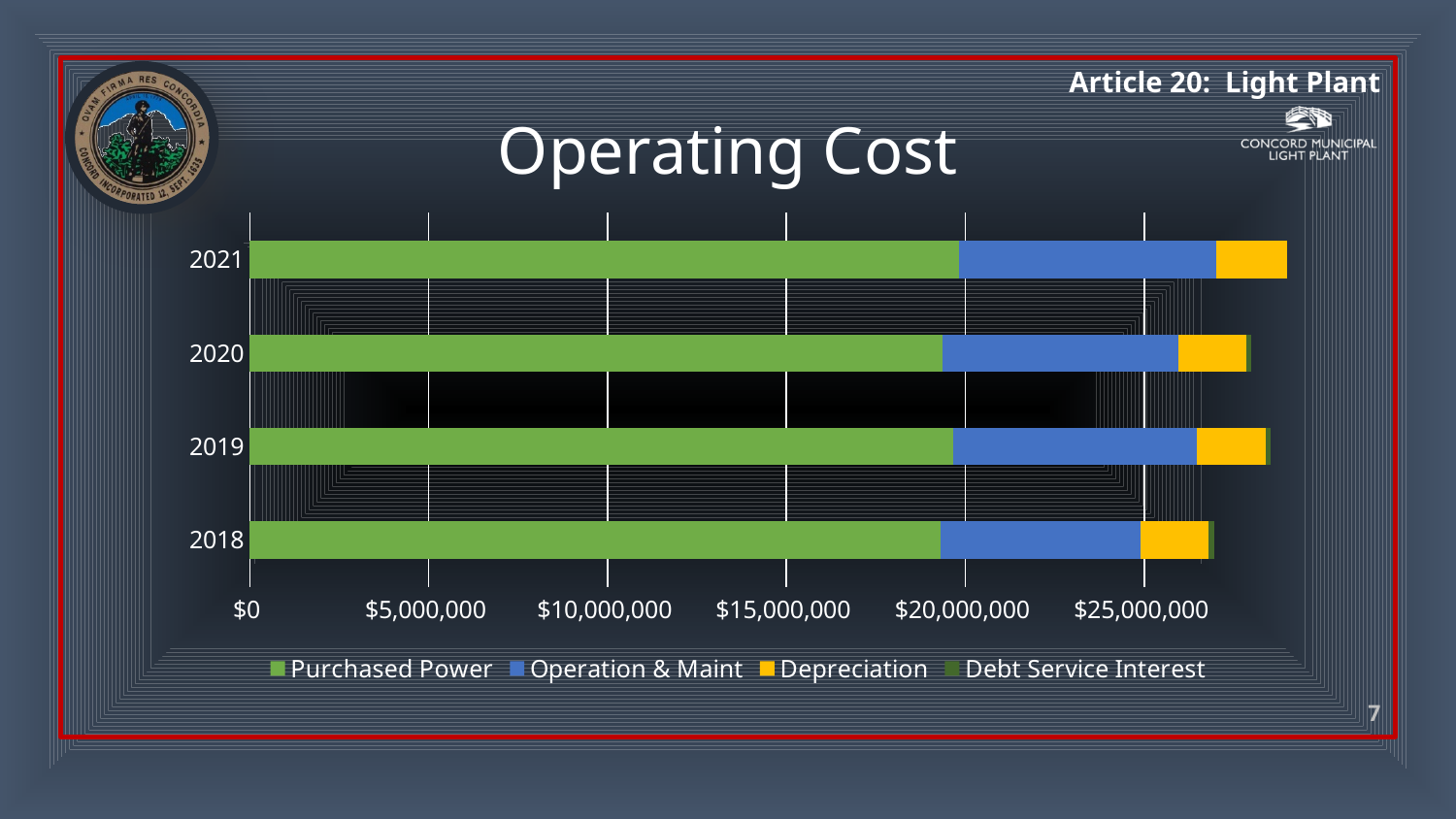
What kind of chart is shown on the slide? Stacked bar chart Is the total operating cost for 2021 greater or less than $25,000,000? greater Is the Purchased Power value for 2019 greater or less than $15,000,000? greater How many series does the legend list? 4 Is the total operating cost bar for 2021 longer or shorter than the bar for 2018? longer How many years are shown on the chart? 4 Which year has the longest total operating cost bar? 2021 Which year has the shortest total operating cost bar? 2018 Is the total operating cost for 2018 greater or less than $25,000,000? greater What is the title of the chart? Operating Cost Which series is shown in green in the legend? Purchased Power